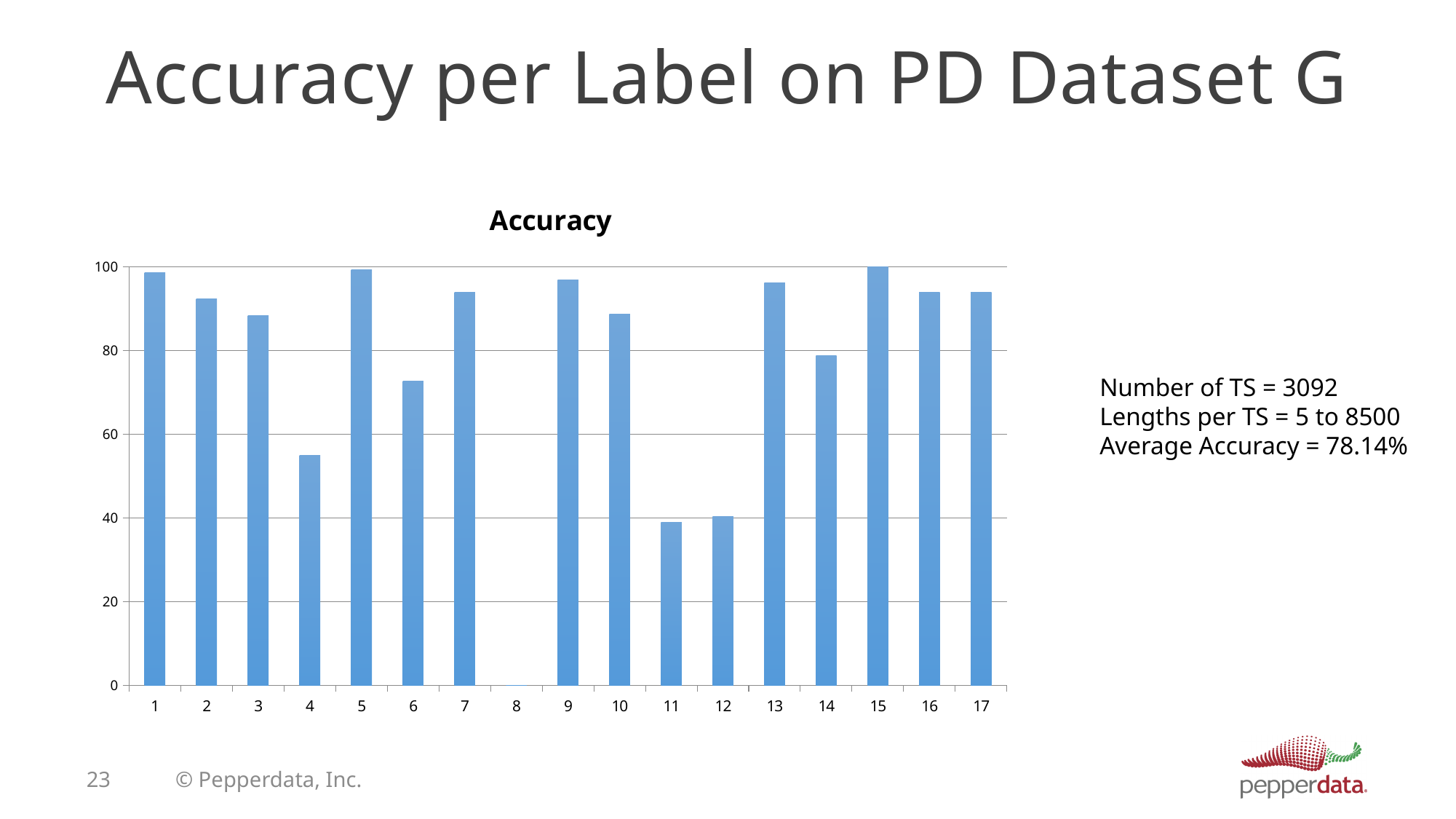
Is the value for label 14 greater or less than 60? greater Is the value for label 4 greater or less than 60? less Is the value for label 4 greater or less than 40? greater How many categories are shown on the x axis of the chart? 17 Which has the larger value, label 11 or label 13? label 13 What is the highest value shown on the y axis of the chart? 100 What is the title of the chart? Accuracy Which has the larger value, label 4 or label 6? label 6 What kind of chart is shown on the slide? bar chart What is the accuracy value for label 15? 100